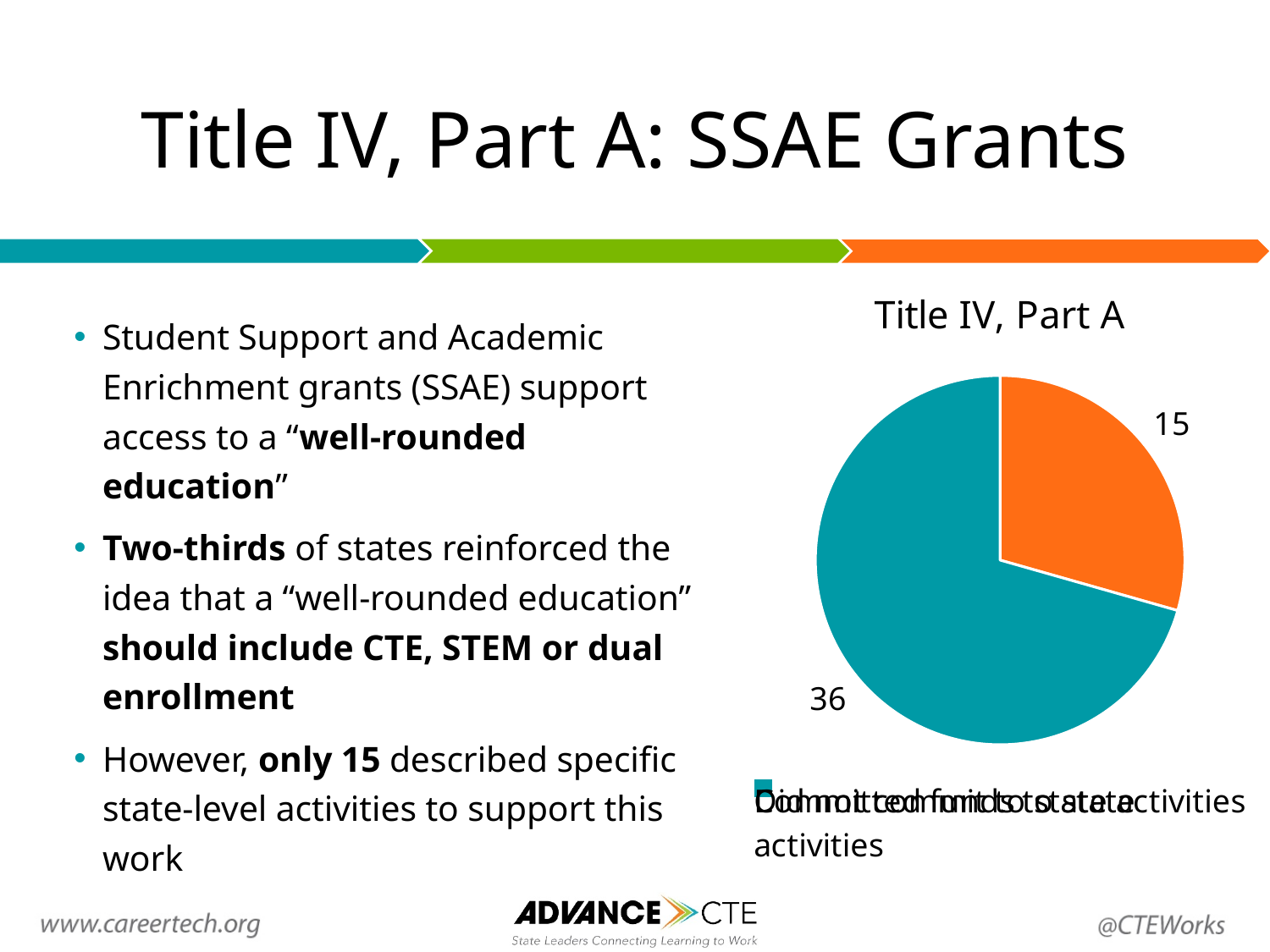
What is the title of the pie chart? Title IV, Part A What share of the pie chart total does the orange slice (15) represent? 29.4% Which slice of the pie chart is the smallest? The orange slice (15) What is the difference between the teal slice value and the orange slice value in the pie chart? 21 What value is labelled on the orange slice of the pie chart? 15 What value is labelled on the teal slice of the pie chart? 36 Which slice of the pie chart is the largest? The teal slice (36) What kind of chart is shown on the slide? Pie chart Which is larger in the pie chart, the teal slice or the orange slice? The teal slice What is the total of the two values shown in the pie chart? 51 How many slices does the pie chart have? 2 What two colours are used for the slices of the pie chart? Orange and teal